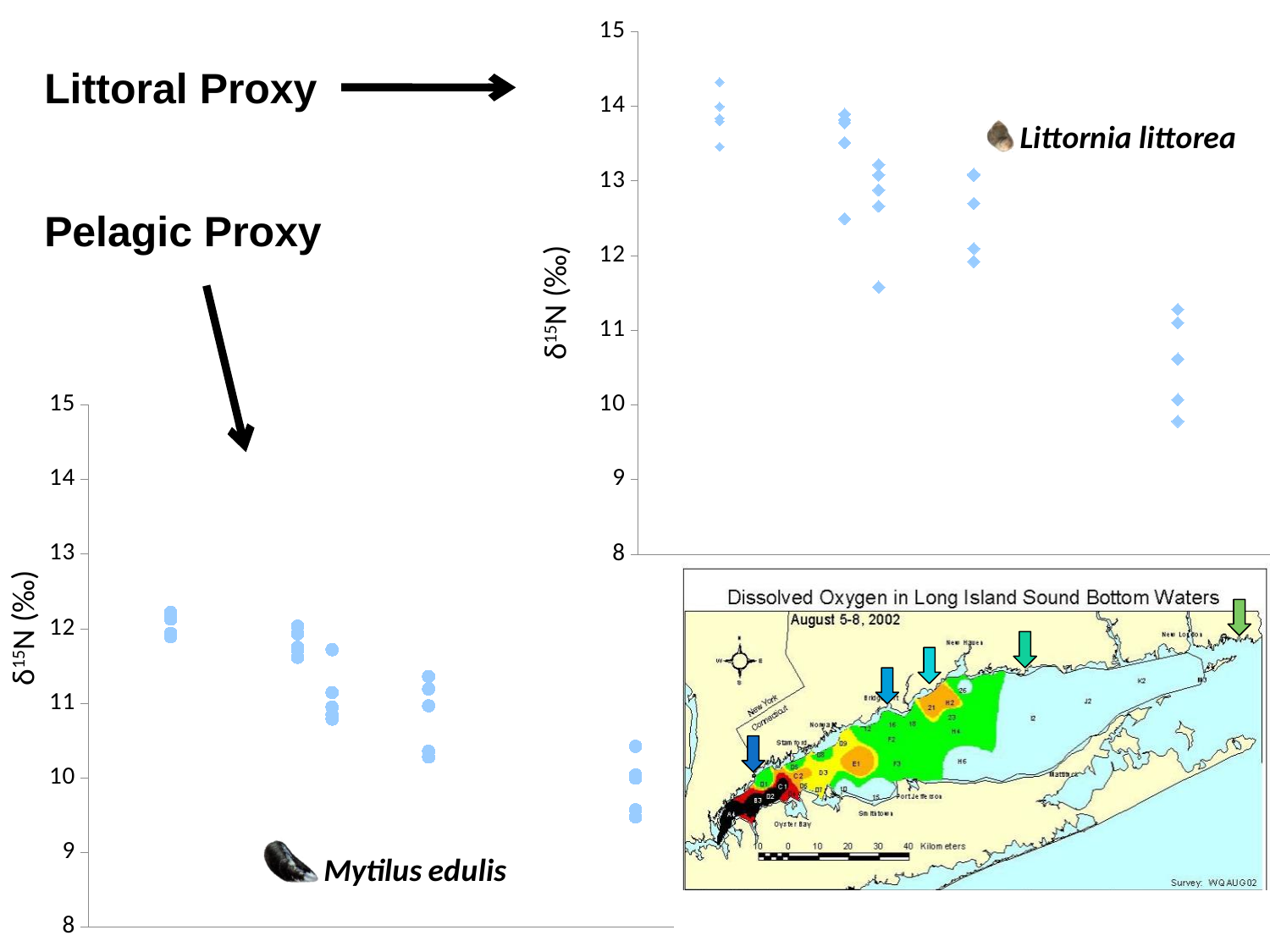
In the Mytilus edulis chart, are the values of the rightmost group of points greater or less than 11? less What kind of chart is the Mytilus edulis chart at the bottom left of the slide? scatter chart What is the y-axis label on the Littornia littorea chart? δ15N (‰) In the Mytilus edulis chart, are the values of the leftmost group of points greater or less than 11? greater In the Mytilus edulis chart, do the δ15N values generally rise or fall from left to right along the x axis? fall What are the minimum and maximum values shown on the y axis of the Mytilus edulis chart? 8 and 15 In the Littornia littorea chart, do the δ15N values generally rise or fall from left to right along the x axis? fall In the Littornia littorea chart, are the values of the leftmost group of points greater or less than 13? greater In the Mytilus edulis chart, which group of points has higher δ15N values, the leftmost group or the rightmost group? the leftmost group What kind of chart is the Littornia littorea chart at the top right of the slide? scatter chart In the Littornia littorea chart, which group of points has higher δ15N values, the leftmost group or the rightmost group? the leftmost group